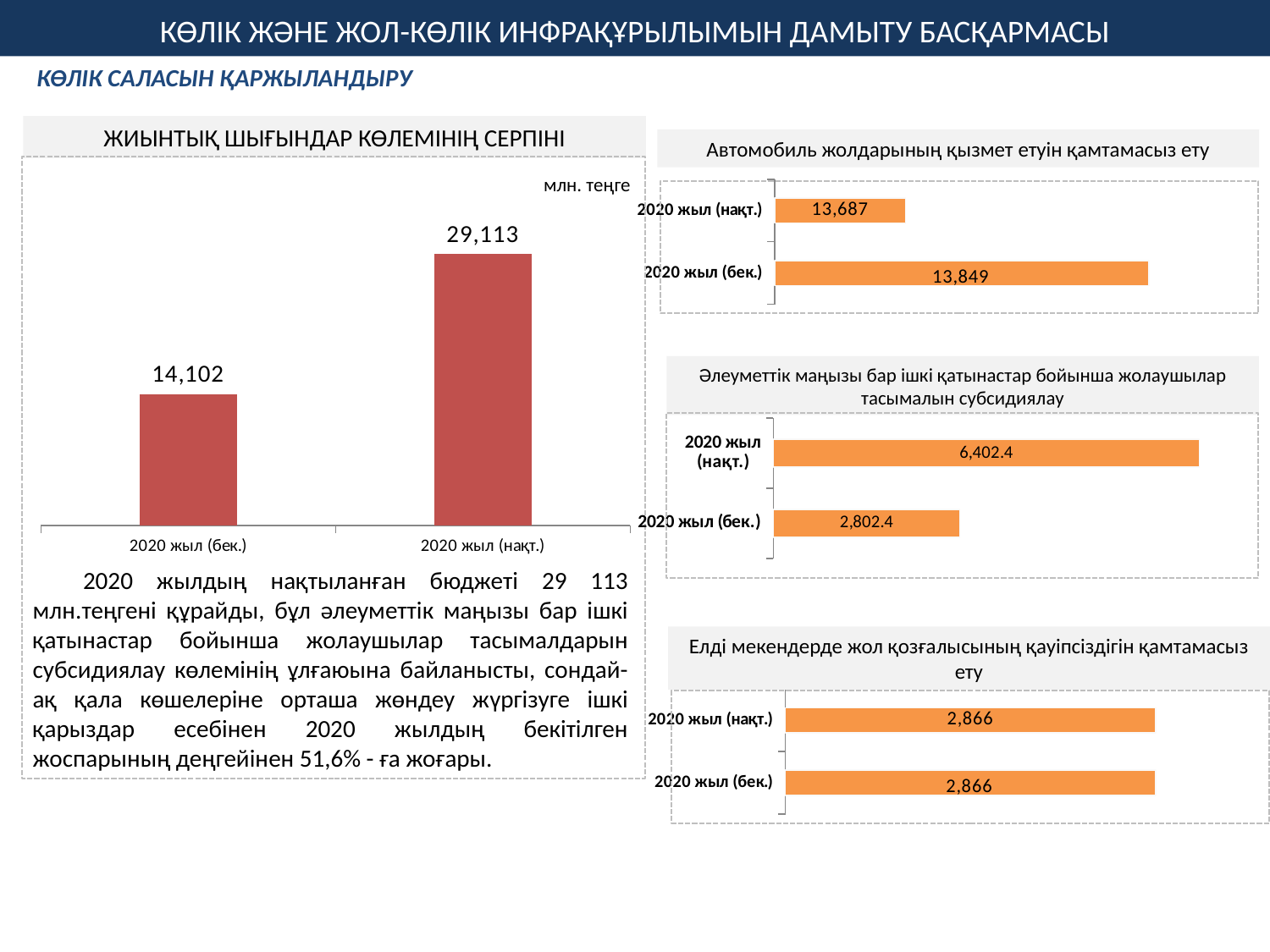
In the chart titled Автомобиль жолдарының қызмет етуін қамтамасыз ету, what is the value for 2020 жыл (нақт.)? 13,687 In the chart titled Әлеуметтік маңызы бар ішкі қатынастар бойынша жолаушылар тасымалын субсидиялау, what is the difference between the 2020 жыл (нақт.) and 2020 жыл (бек.) values? 3,600 In the chart titled Автомобиль жолдарының қызмет етуін қамтамасыз ету, what is the difference between the 2020 жыл (бек.) and 2020 жыл (нақт.) values? 162 In the chart titled Әлеуметтік маңызы бар ішкі қатынастар бойынша жолаушылар тасымалын субсидиялау, which category has the higher value, 2020 жыл (нақт.) or 2020 жыл (бек.)? 2020 жыл (нақт.) In the chart titled ЖИЫНТЫҚ ШЫҒЫНДАР КӨЛЕМІНІҢ СЕРПІНІ, what unit is shown for the values? млн. теңге In the chart titled Әлеуметтік маңызы бар ішкі қатынастар бойынша жолаушылар тасымалын субсидиялау, what is the value for 2020 жыл (нақт.)? 6,402.4 In the chart titled ЖИЫНТЫҚ ШЫҒЫНДАР КӨЛЕМІНІҢ СЕРПІНІ, what is the difference between the 2020 жыл (нақт.) and 2020 жыл (бек.) values? 15,011 What kind of chart is the one titled ЖИЫНТЫҚ ШЫҒЫНДАР КӨЛЕМІНІҢ СЕРПІНІ? Bar chart In the chart titled ЖИЫНТЫҚ ШЫҒЫНДАР КӨЛЕМІНІҢ СЕРПІНІ, what is the value for 2020 жыл (бек.)? 14,102 In the chart titled Елді мекендерде жол қозғалысының қауіпсіздігін қамтамасыз ету, what is the value for 2020 жыл (бек.)? 2,866 In the chart titled Автомобиль жолдарының қызмет етуін қамтамасыз ету, what is the value for 2020 жыл (бек.)? 13,849 In the chart titled ЖИЫНТЫҚ ШЫҒЫНДАР КӨЛЕМІНІҢ СЕРПІНІ, what is the value for 2020 жыл (нақт.)? 29,113